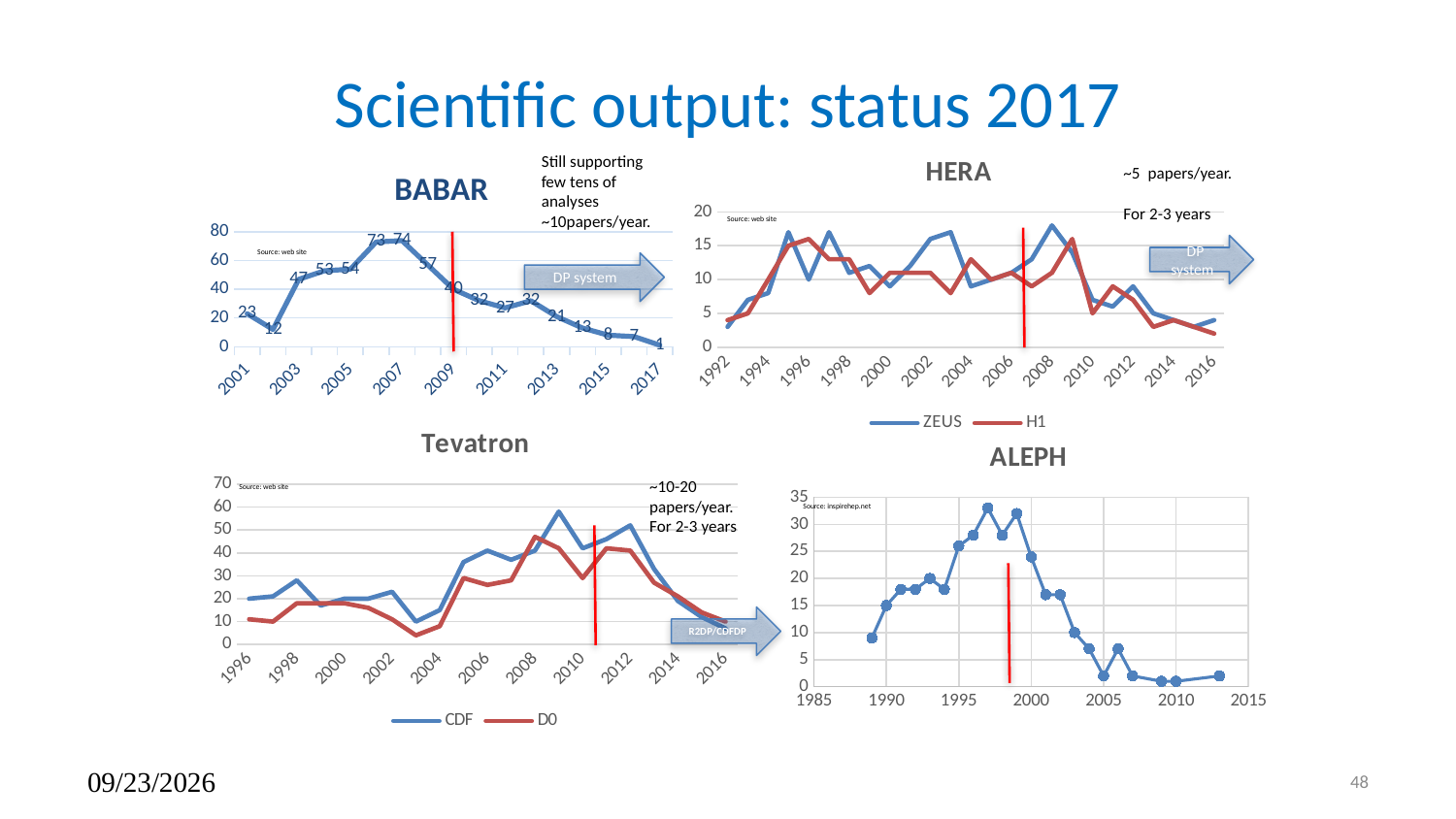
On the HERA chart, how many series does the legend list? 2 On the BABAR chart, which year has the highest value? 2007 On the BABAR chart, which year has the lowest value? 2017 On the Tevatron chart, is the CDF value for 2009 greater or less than 50? greater On the ALEPH chart, is the value for 1997 greater or less than 30? greater On the BABAR chart, what is the difference between the values for 2007 and 2001? 51 On the BABAR chart, which is larger, the value for 2003 or the value for 2013? 2003 On the BABAR chart, what is the value for 2007? 74 On the Tevatron chart, which series does the legend list? CDF and D0 On the BABAR chart, do the values rise or fall from 2007 to 2017? fall What kind of chart is the HERA chart? line chart On the BABAR chart, how many data points are plotted? 17